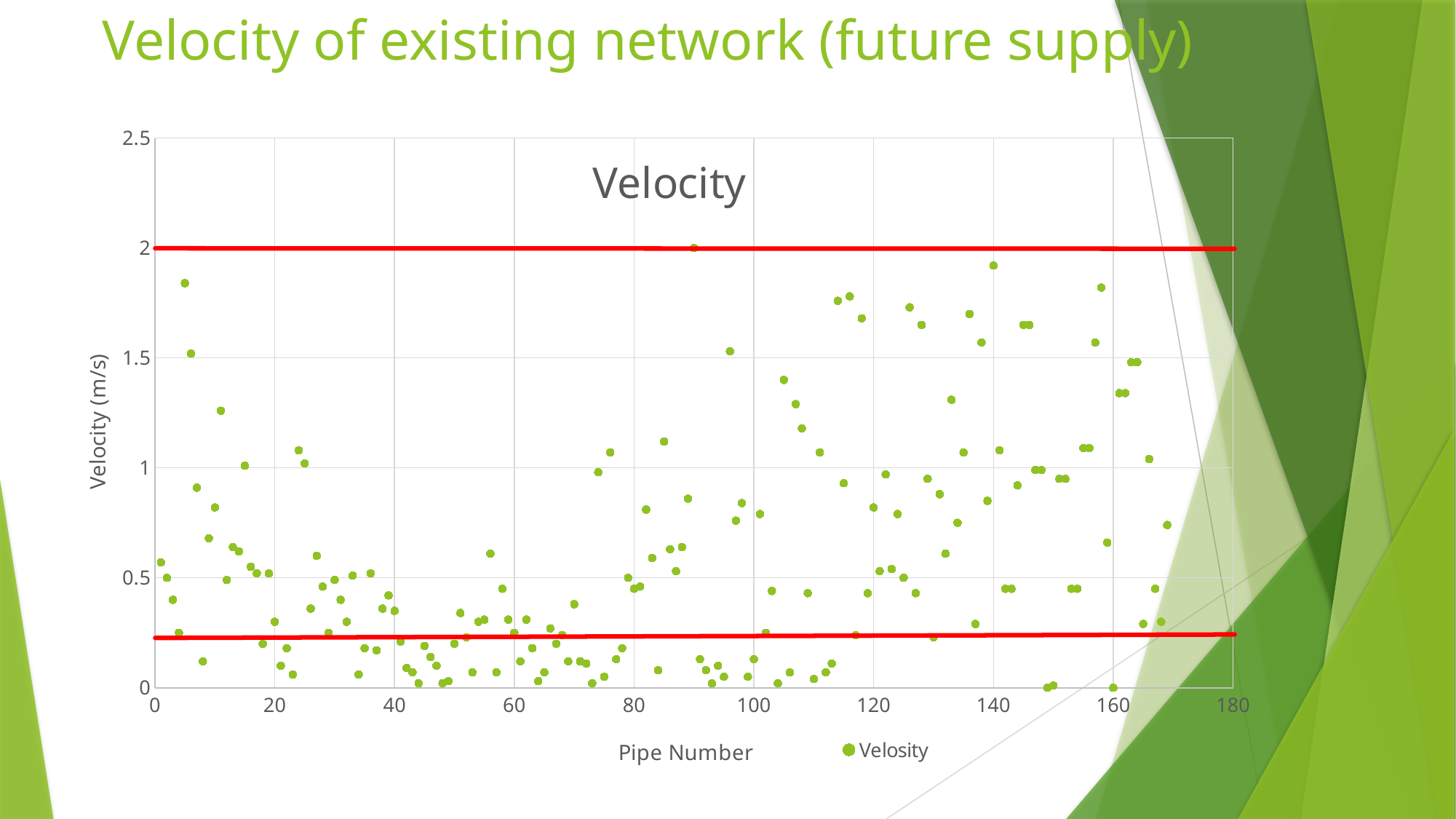
What kind of chart is shown on the slide? scatter chart Is the plotted velocity for the pipe near pipe number 5 greater or less than 1.5? greater What is the maximum value shown on the y axis of the chart? 2.5 Is the plotted velocity for the pipe near pipe number 48 greater or less than 0.5? less What is the title of the chart? Velocity Is the highest plotted velocity value on the chart greater or less than 1.5? greater What is the maximum value shown on the x axis of the chart? 180 How many series does the chart legend list? 1 What is the label of the x axis of the chart? Pipe Number